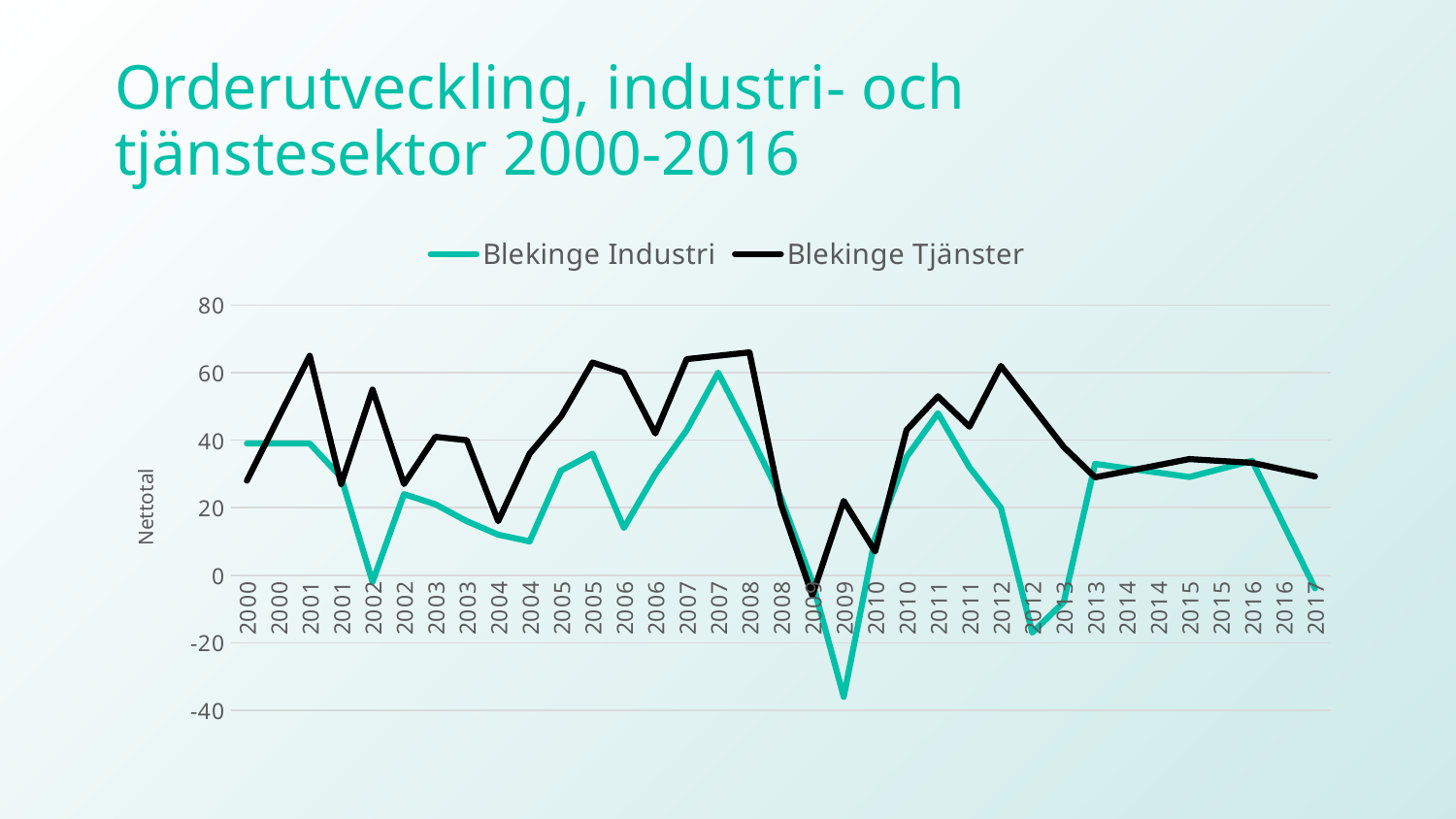
Does the Blekinge Industri line rise or fall between 2016 and 2017? fall Is the value for Blekinge Tjänster at the first 2004 point greater or less than 20? less Does the Blekinge Industri line rise or fall between the second 2008 point and the second 2009 point? fall How many series does the legend list? 2 What kind of chart is shown on the slide? line chart At the first 2012 point, which series has the higher value, Blekinge Industri or Blekinge Tjänster? Blekinge Tjänster In which year does the Blekinge Industri line reach its lowest point? 2009 What is the label on the vertical axis? Nettotal Is the highest value of Blekinge Tjänster greater or less than 60? greater Is the lowest value of Blekinge Industri greater or less than -20? less What are the two series named in the legend? Blekinge Industri and Blekinge Tjänster At the first 2000 point, which series has the higher value, Blekinge Industri or Blekinge Tjänster? Blekinge Industri